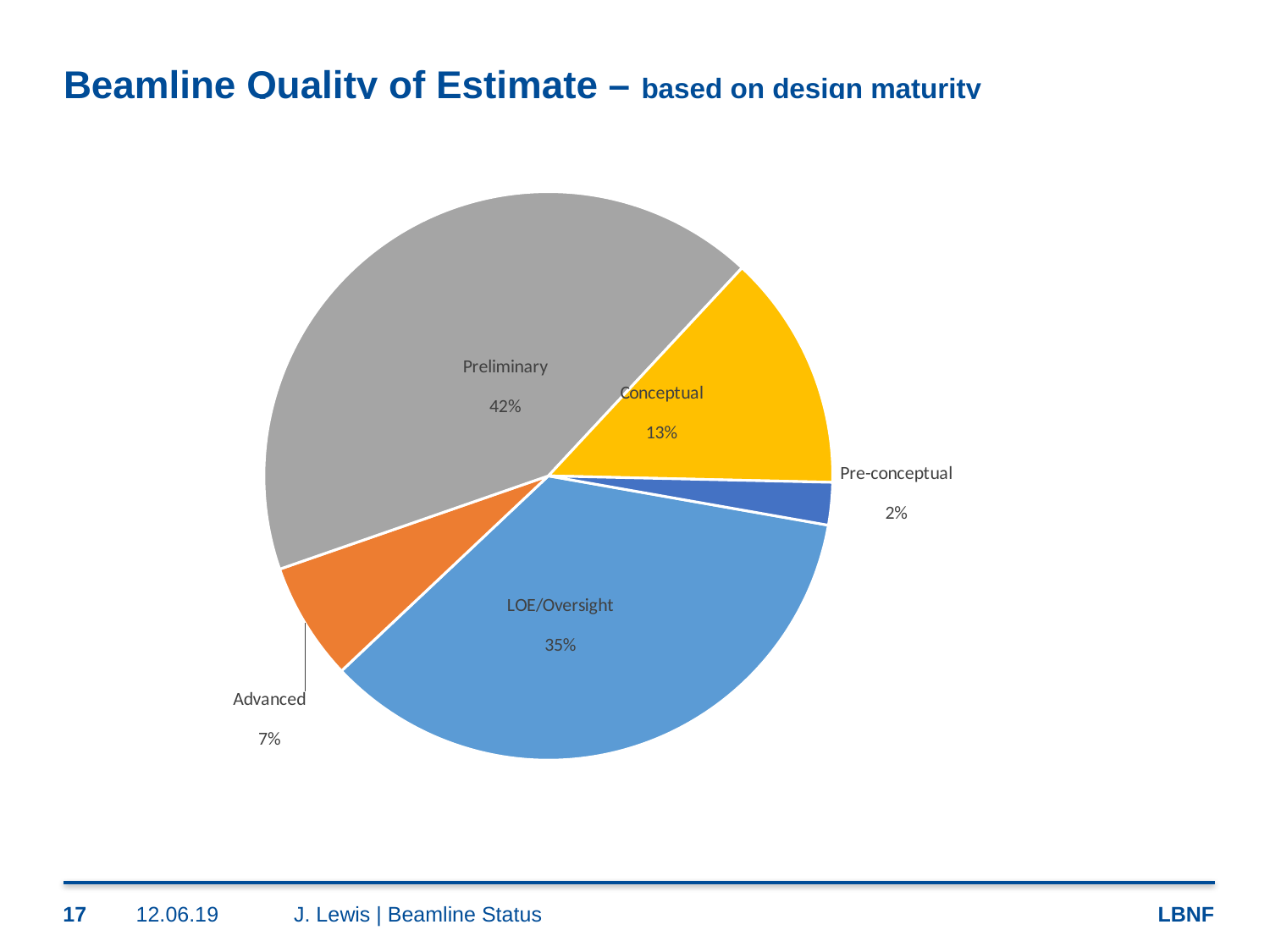
Which category has the smallest slice of the pie? Pre-conceptual What share of the pie does Preliminary represent? 42% What colour is the Preliminary slice? grey Which is larger, Conceptual or Advanced? Conceptual What is the value shown for Pre-conceptual? 2% Which category has the largest slice of the pie? Preliminary What is the value shown for Conceptual? 13% What is the difference between the Preliminary and LOE/Oversight shares? 7% What is the value shown for Advanced? 7% What is the value shown for LOE/Oversight? 35% How many categories are shown in the pie chart? 5 What kind of chart is shown on the slide? pie chart